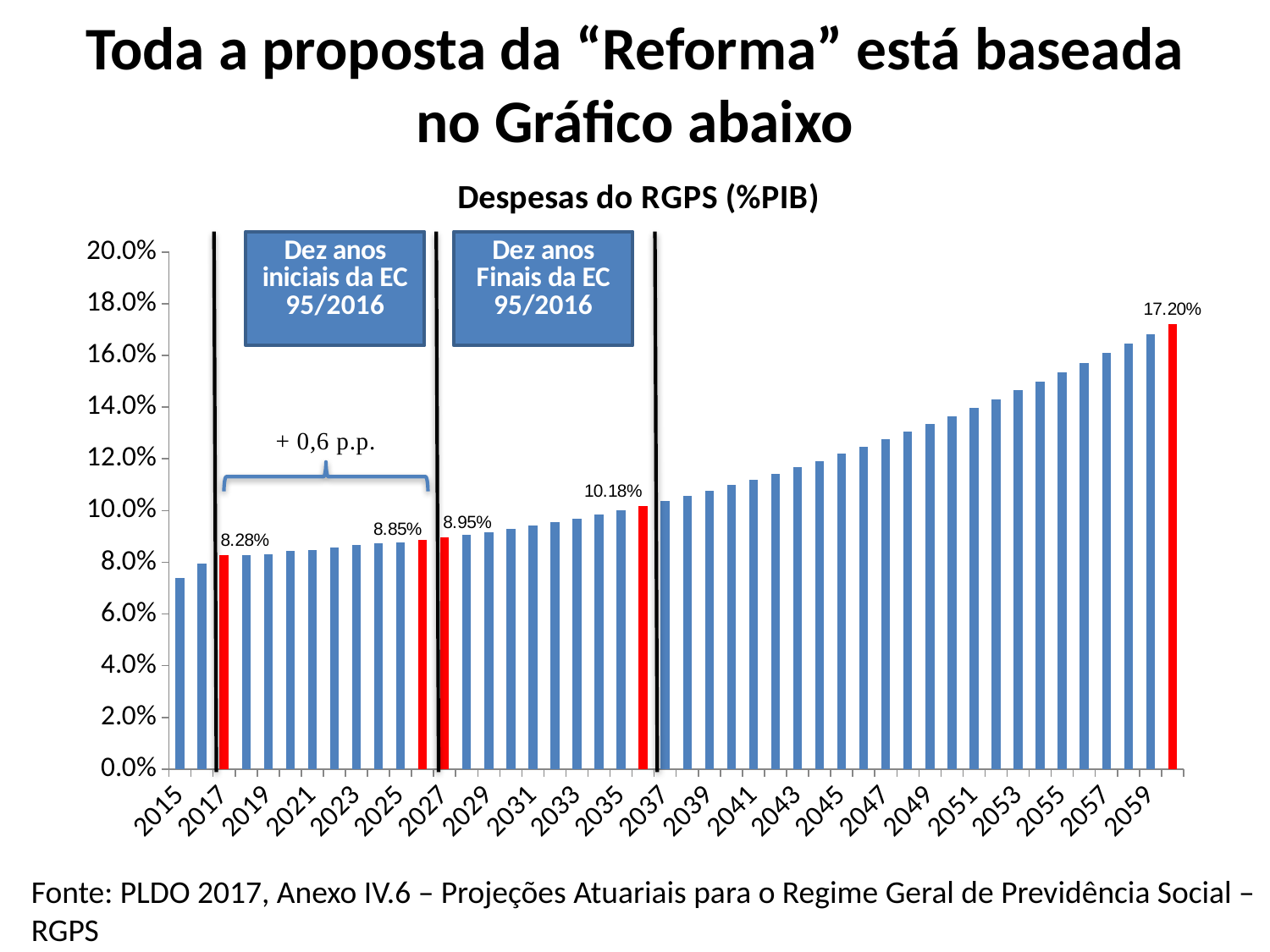
Which is larger, the value for 2017 or the value for 2027? 2027 What is the difference between the labeled values for 2027 and 2017? 0.67 percentage points What is the value labeled on the red bar for 2017? 8.28% What value is labeled on the red bar immediately to the left of the vertical line at 2037? 10.18% Is the value for 2015 greater or less than 8.0%? less What kind of chart is shown on the slide? bar chart What is the highest value labeled on the chart? 17.20% What is the title of the chart? Despesas do RGPS (%PIB) What is the value labeled on the red bar for 2027? 8.95% Which year has the lowest bar on the chart? 2015 Is the value for 2053 greater or less than 14.0%? greater Do the values generally rise or fall from 2015 to the last year shown? rise